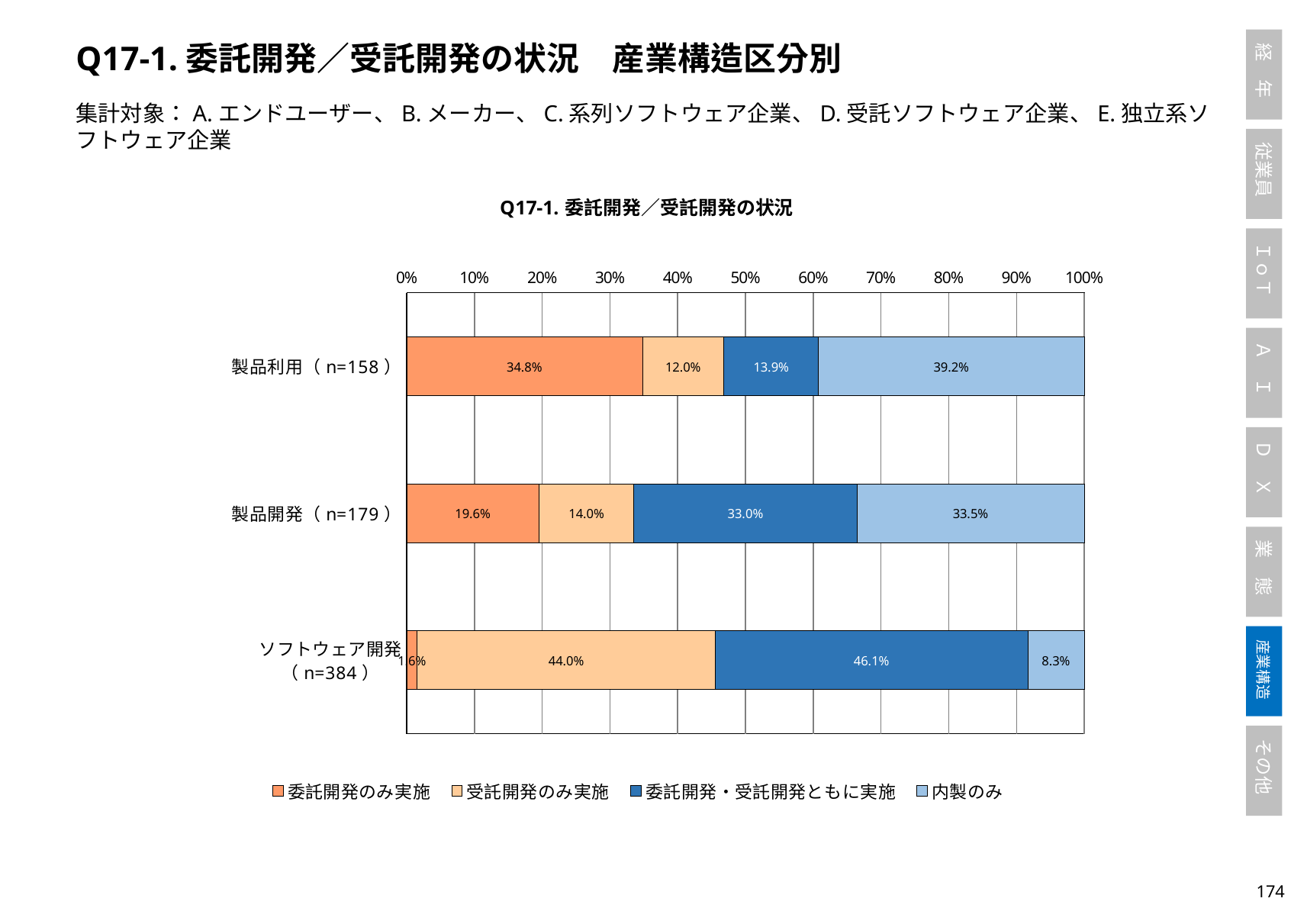
Which category has the lowest value for 委託開発・受託開発ともに実施? 製品利用（n=158） What is the title of the chart? Q17-1. 委託開発／受託開発の状況 What kind of chart is shown on the slide? Stacked bar chart What is the value of 内製のみ for 製品利用（n=158）? 39.2% For 製品利用（n=158）, what is the difference between 委託開発のみ実施 and 受託開発のみ実施? 22.8 percentage points How many categories (bars) are shown in the chart? 3 What is the value of 委託開発・受託開発ともに実施 for 製品開発（n=179）? 33.0% What is the value of 受託開発のみ実施 for ソフトウェア開発（n=384）? 44.0% Is the value of 委託開発のみ実施 for ソフトウェア開発（n=384）greater or less than 10%? less For 製品利用（n=158）, which is larger: 委託開発のみ実施 or 内製のみ? 内製のみ Which category has the highest value for 内製のみ? 製品利用（n=158） How many series does the legend list? 4